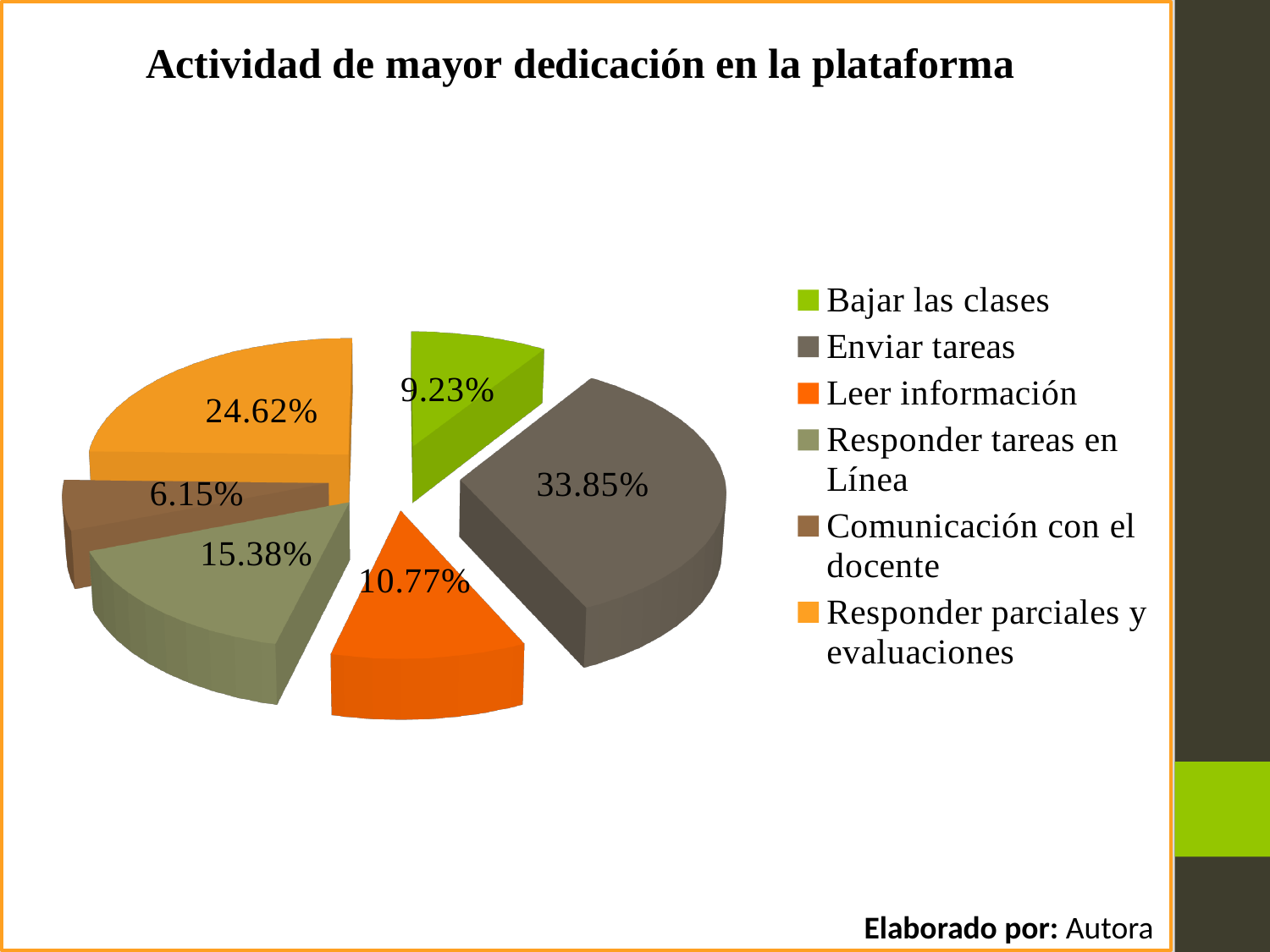
Which is larger, the share for Responder tareas en Línea or the share for Leer información? Responder tareas en Línea Which activity has the largest share of the pie? Enviar tareas What percentage is shown for Leer información? 10.77% What percentage is shown for Comunicación con el docente? 6.15% How many categories does the legend list? 6 What type of chart is shown on the slide? Pie chart What percentage is shown for Responder parciales y evaluaciones? 24.62% Which activity has the smallest share of the pie? Comunicación con el docente What percentage is shown for Bajar las clases? 9.23% What is the title of the chart? Actividad de mayor dedicación en la plataforma What is the difference between the shares for Enviar tareas and Responder parciales y evaluaciones? 9.23% What percentage is shown for Enviar tareas? 33.85%